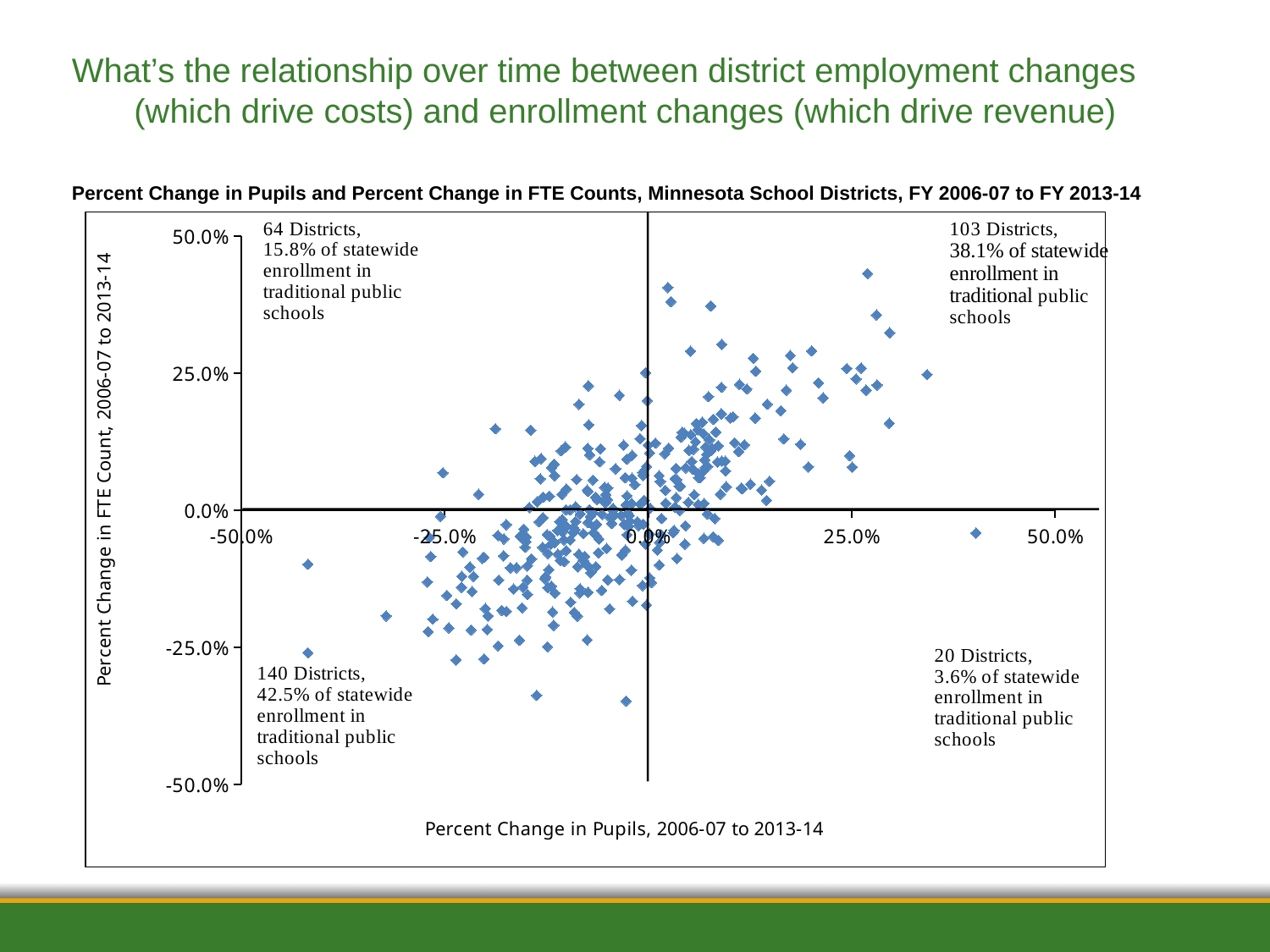
How many districts are in the lower-right quadrant? 20 Districts Which quadrant contains the most districts? Lower-left (140 Districts) What is the title of the chart? Percent Change in Pupils and Percent Change in FTE Counts, Minnesota School Districts, FY 2006-07 to FY 2013-14 Do the points generally rise or fall as the percent change in pupils increases along the x axis? Rise What kind of chart is shown on the slide? Scatter plot How many more districts are in the lower-left quadrant than in the lower-right quadrant? 120 What share of statewide enrollment do the 64 districts in the upper-left quadrant represent? 15.8% What share of statewide enrollment in traditional public schools do the districts in the lower-left quadrant represent? 42.5% Which quadrant contains the fewest districts? Lower-right (20 Districts) What is the total number of districts across the four quadrant annotations? 327 How many districts are in the upper-right quadrant (positive pupil change and positive FTE change)? 103 Districts What is the label of the vertical axis? Percent Change in FTE Count, 2006-07 to 2013-14